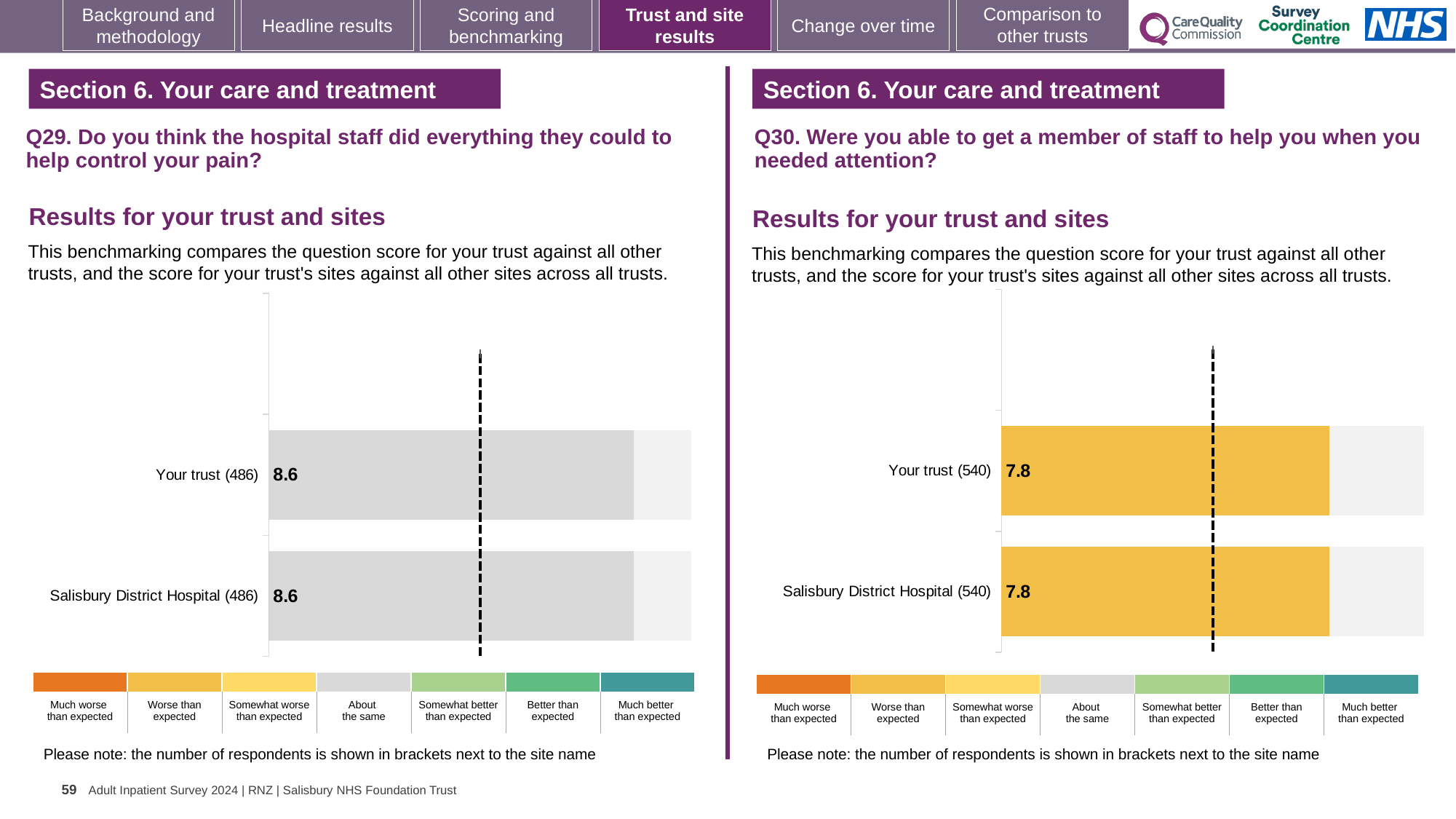
How many bars are plotted on the Q30 chart (right)? 2 On the Q30 chart (right), how many respondents are shown in brackets for Salisbury District Hospital? 540 On the Q30 chart (right), what is the score for Salisbury District Hospital? 7.8 On the Q29 chart (left), how many respondents are shown in brackets for Your trust? 486 On the Q30 chart (right), what is the difference between the score for Your trust and the score for Salisbury District Hospital? 0 On the Q29 chart (left), what is the score for Your trust? 8.6 What kind of chart is used for the Q30 results (right)? Bar chart On the Q29 chart (left), what is the difference between the score for Your trust and the score for Salisbury District Hospital? 0 How many bars are plotted on the Q29 chart (left)? 2 On the Q30 chart (right), what is the score for Your trust? 7.8 According to the colour key, which benchmark category do the bars on the Q29 chart (left) fall into? About the same On the Q29 chart (left), what is the score for Salisbury District Hospital? 8.6